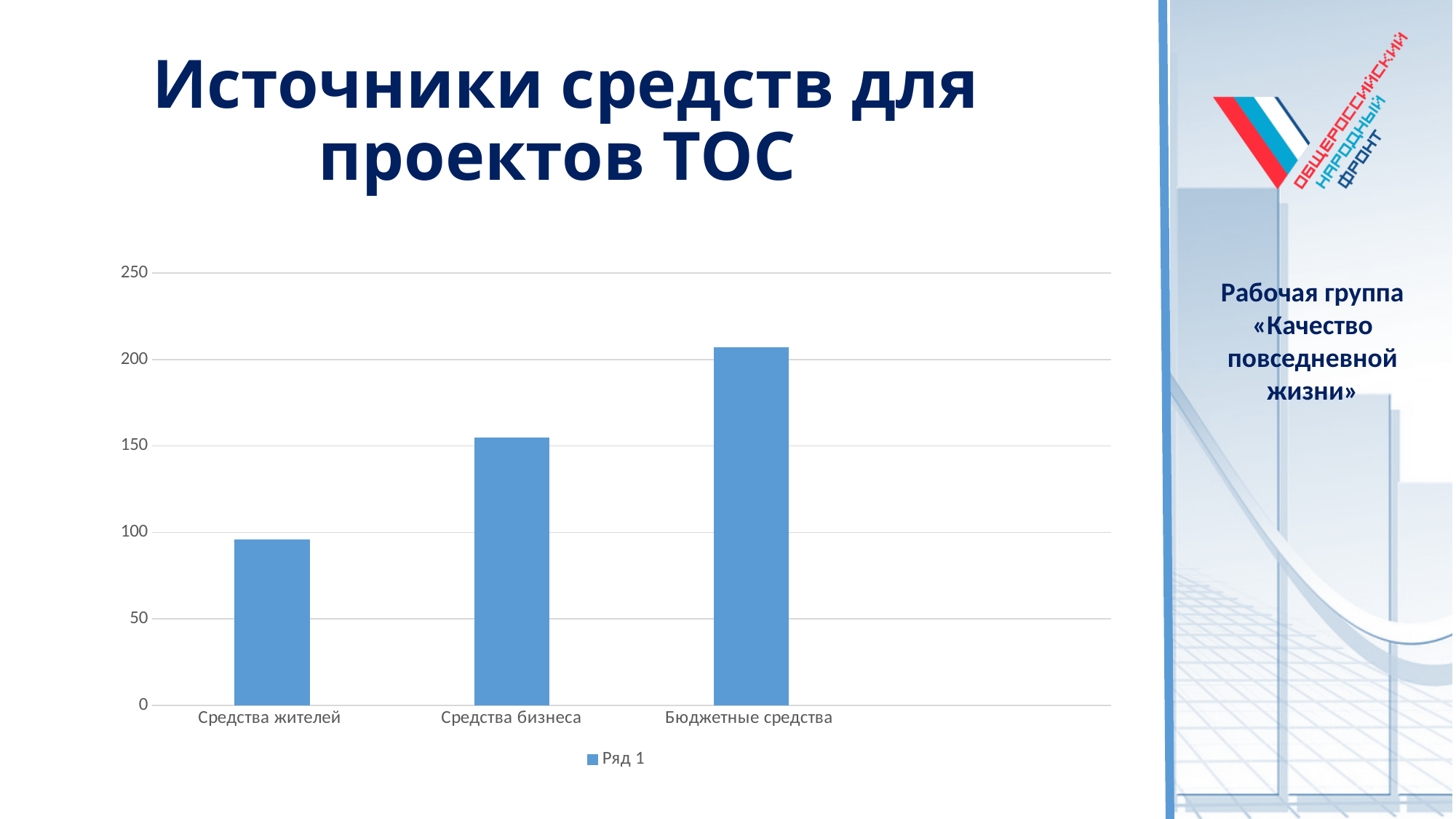
Do the values rise or fall from left to right along the x axis? rise How many categories are shown on the x axis of the chart? 3 Which is larger: the value for Средства бизнеса or the value for Средства жителей? Средства бизнеса What is the title of the slide containing the chart? Источники средств для проектов ТОС What is the name of the series shown in the chart legend? Ряд 1 How many series does the chart legend list? 1 Which category has the lowest value in the chart? Средства жителей Which category has the highest value in the chart? Бюджетные средства Is the value for Средства бизнеса greater or less than 100? greater Is the value for Средства жителей greater or less than 150? less Is the value for Бюджетные средства greater or less than 200? greater What kind of chart is shown on the slide? bar chart